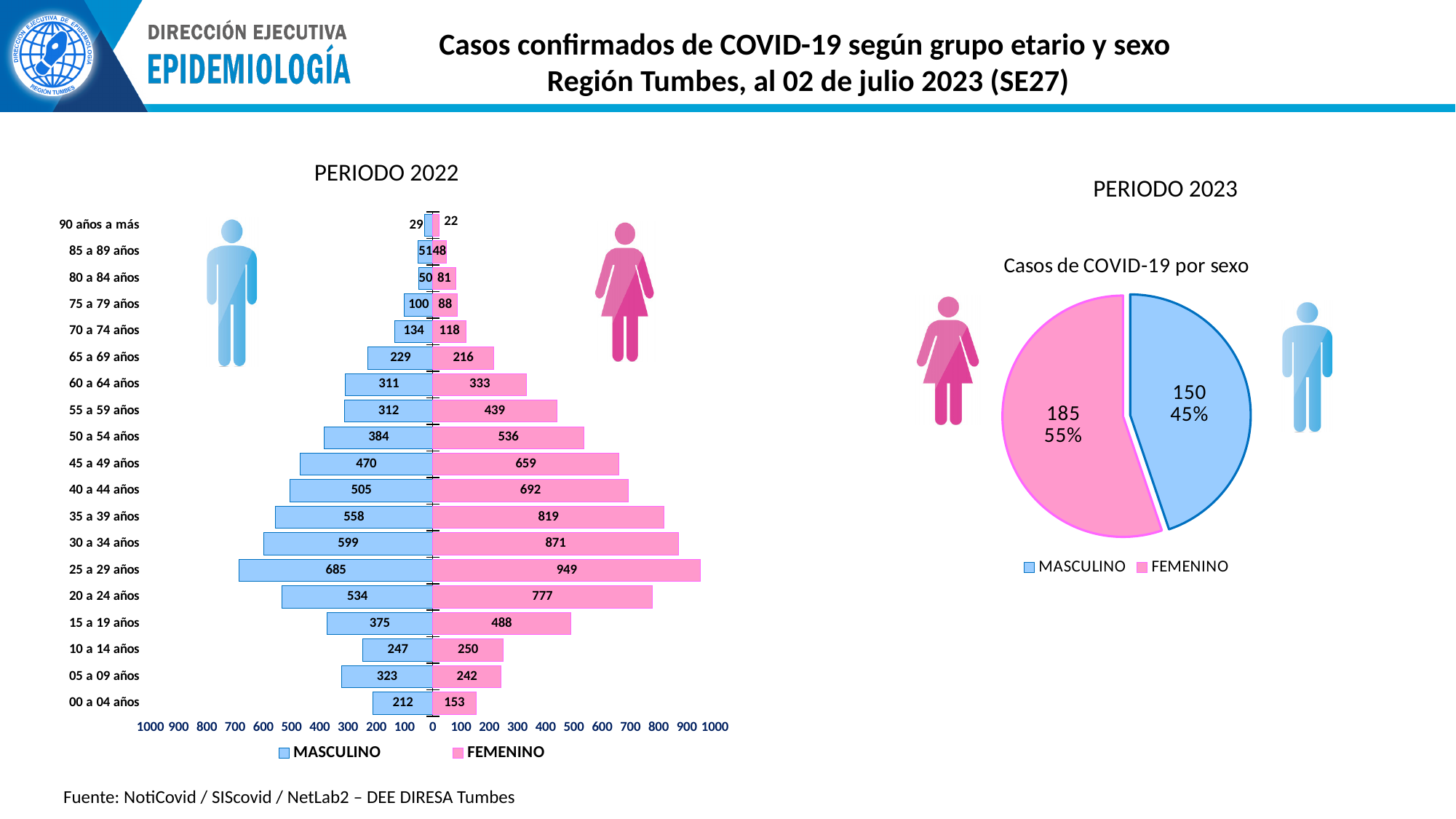
In the PERIODO 2022 chart, what is the difference between the FEMENINO and MASCULINO values for 25 a 29 años? 264 In the PERIODO 2022 chart, what is the MASCULINO value for 45 a 49 años? 470 In the PERIODO 2022 chart, how many FEMENINO cases are shown for the 25 a 29 años group? 949 In the PERIODO 2023 pie chart, what is the total number of cases across both sexes? 335 In the PERIODO 2023 pie chart, what share of cases is MASCULINO? 45% In the PERIODO 2022 chart, which age group has the lowest FEMENINO value? 90 años a más What kind of chart is the PERIODO 2022 chart? Bar chart In the PERIODO 2022 chart, for 05 a 09 años, which series has the larger value, MASCULINO or FEMENINO? MASCULINO How many series does the legend of the PERIODO 2022 chart list? 2 In the PERIODO 2023 pie chart, how many FEMENINO cases are shown? 185 In the PERIODO 2022 chart, which age group has the highest FEMENINO value? 25 a 29 años How many age groups are shown in the PERIODO 2022 chart? 19